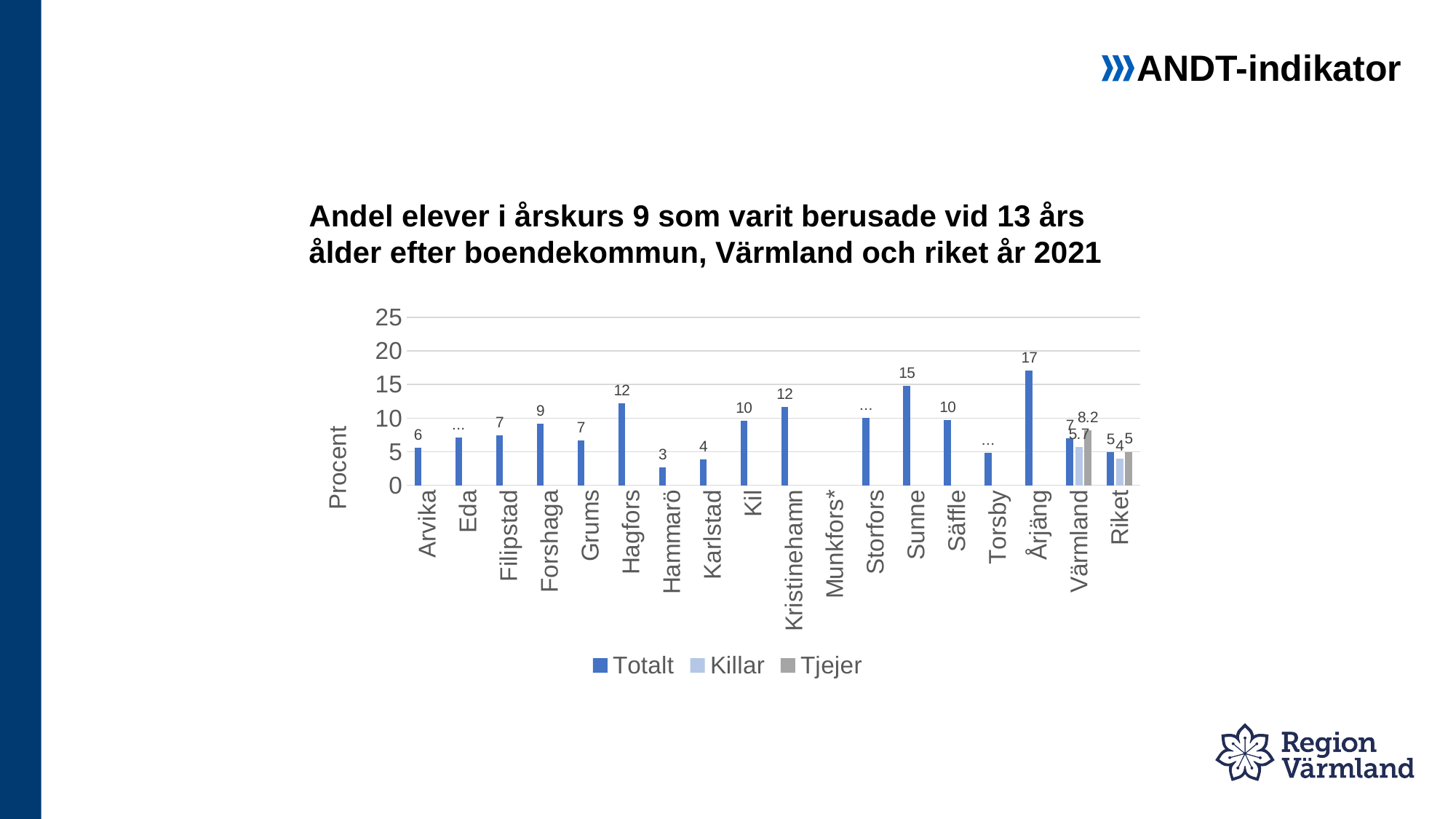
Which municipality has the highest Totalt value? Årjäng What is the Totalt value for Årjäng? 17 What is the Totalt value for Hagfors? 12 What is the difference between the Tjejer and Killar values for Värmland? 2.5 Which has a higher Totalt value, Sunne or Säffle? Sunne What kind of chart is shown on the slide? Bar chart What is the Killar value for Värmland? 5.7 Which municipality has the lowest labelled Totalt value? Hammarö What is the Killar value for Riket? 4 What is the Tjejer value for Värmland? 8.2 How many series does the legend list? 3 What is the difference between the Totalt values for Årjäng and Hammarö? 14